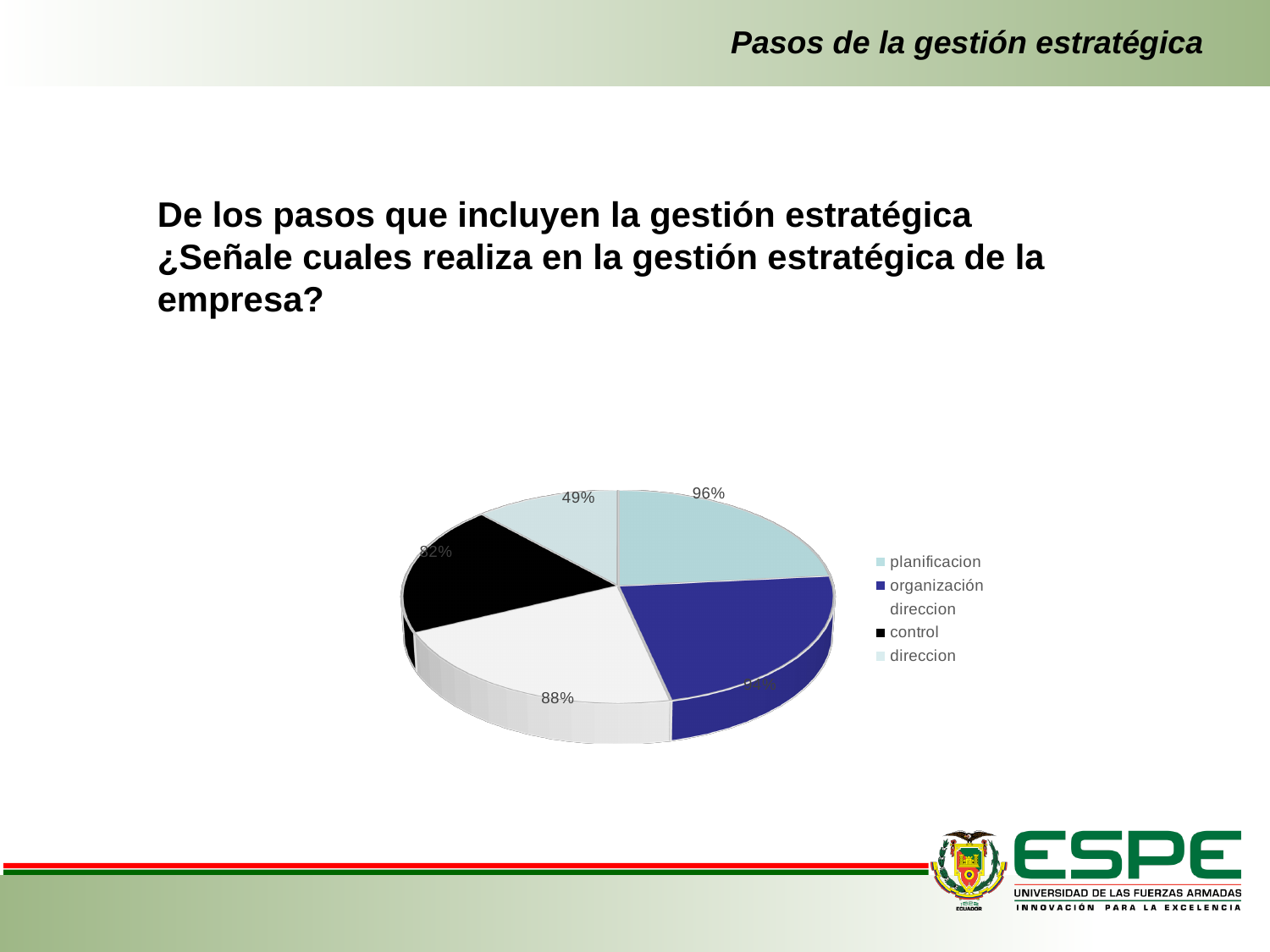
Is the value for control in the pie chart greater or less than 50%? greater What percentage is shown for control in the pie chart? 82% What is the smallest percentage labelled on the pie chart? 49% By how many percentage points does planificacion exceed control in the pie chart? 14 What colour is the control slice in the pie chart? black How many entries does the legend of the pie chart list? 5 What percentage is shown for planificacion in the pie chart? 96% What percentage is shown on the white slice of the pie chart? 88% How many slices does the pie chart have? 5 Which has the larger percentage in the pie chart, planificacion or control? planificacion Which legend entry appears twice in the pie chart's legend? direccion What kind of chart is shown on the slide? pie chart